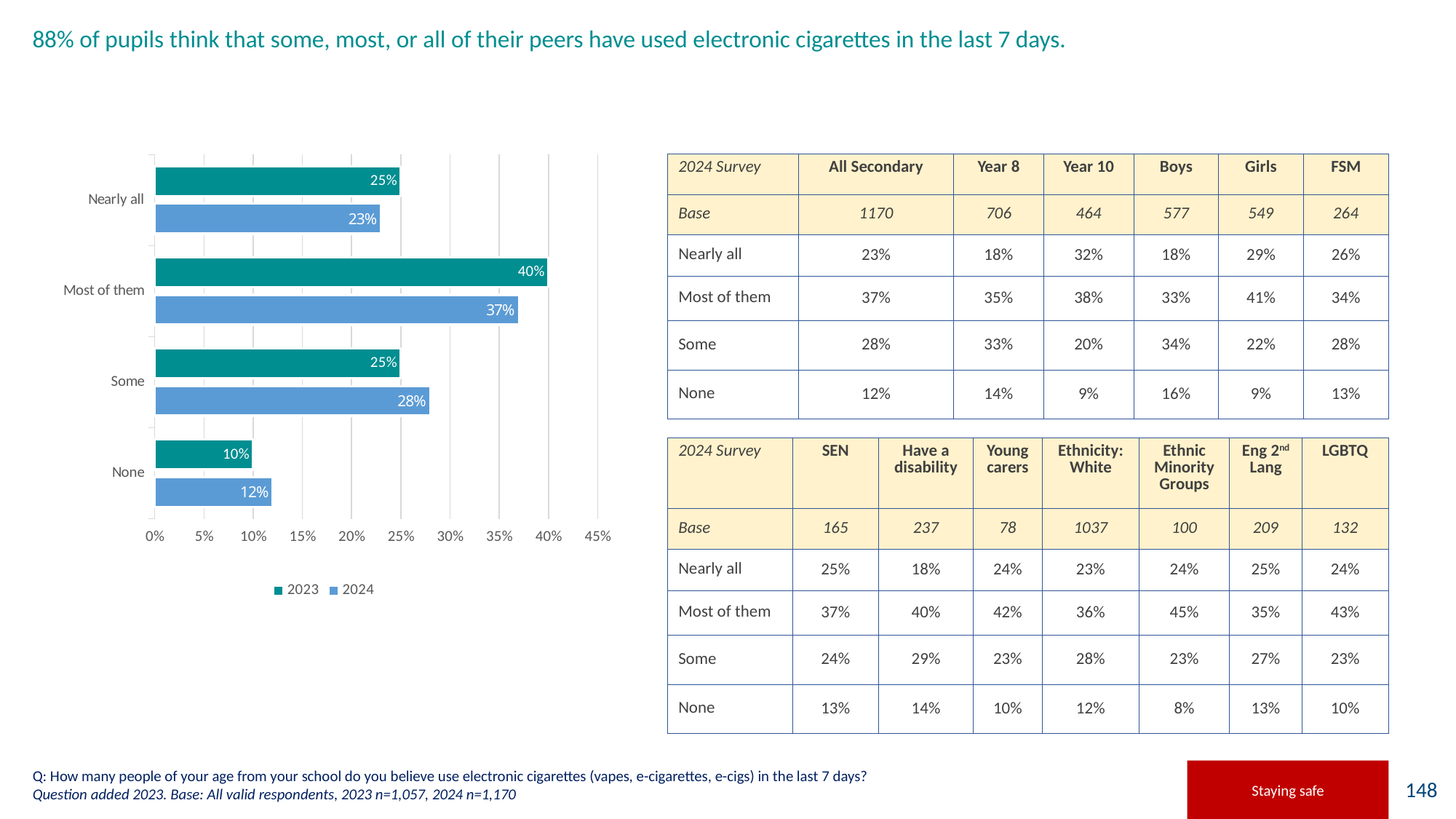
What is the 2024 value for "Some" in the bar chart? 28% What kind of chart is shown on the slide? Bar chart What is the maximum value shown on the x axis of the bar chart? 45% What is the 2023 value for "None" in the bar chart? 10% Which category has the lowest 2024 value in the bar chart? None How many categories are shown in the bar chart? 4 What is the difference between the 2023 and 2024 values for "Most of them" in the bar chart? 3% What is the 2024 value for "Most of them" in the bar chart? 37% Which category has the highest 2023 value in the bar chart? Most of them In the bar chart, is the 2023 value or the 2024 value larger for "Some"? 2024 In the bar chart, is the 2023 value or the 2024 value larger for "Nearly all"? 2023 How many series does the legend of the bar chart list? 2